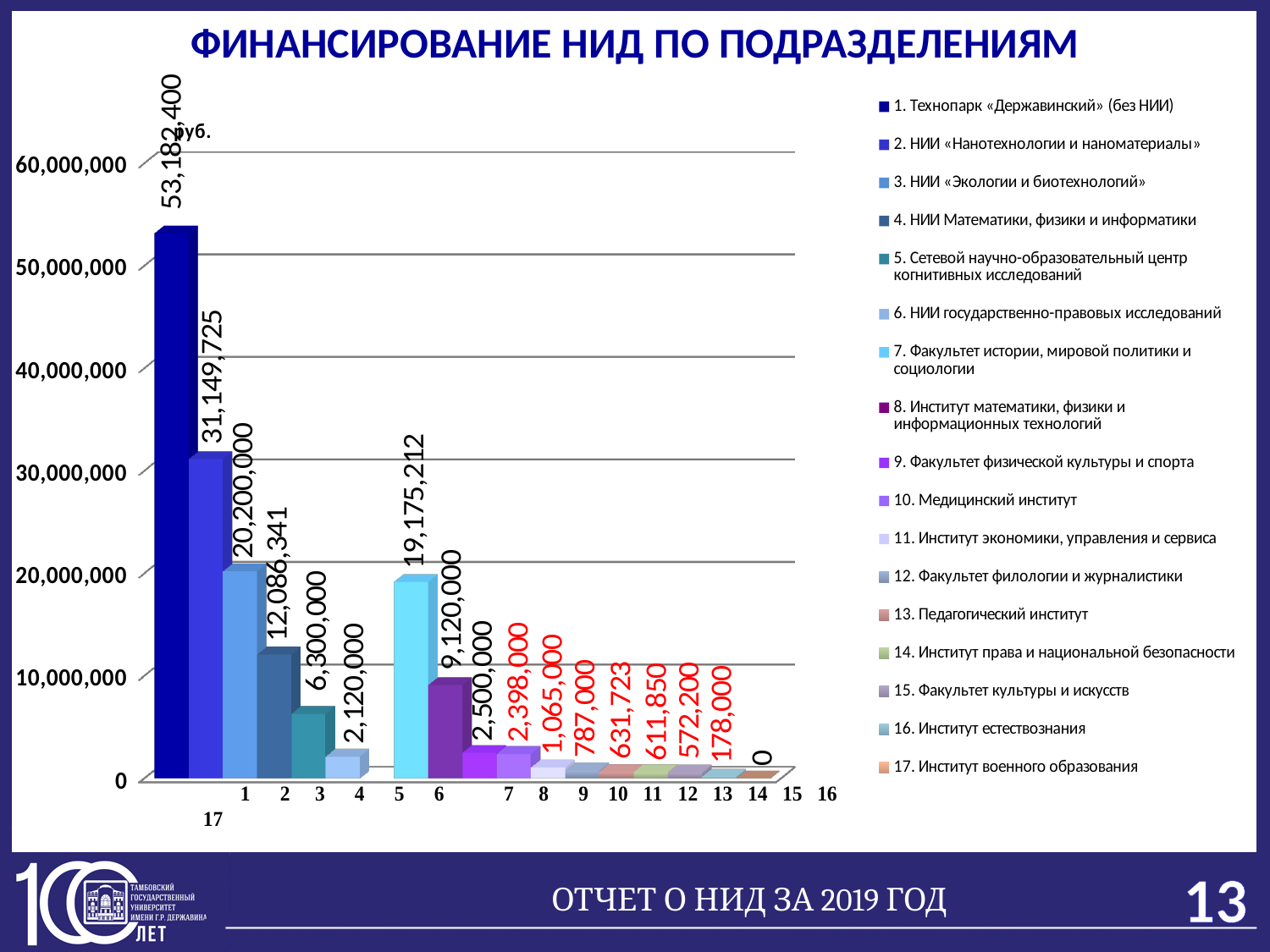
What is the difference between the values for 1. Технопарк «Державинский» (без НИИ) and 2. НИИ «Нанотехнологии и наноматериалы»? 22,032,675 What is the title of the chart? ФИНАНСИРОВАНИЕ НИД ПО ПОДРАЗДЕЛЕНИЯМ What is the value shown for 17. Институт военного образования? 0 What kind of chart is shown on the slide? bar chart Is the value for 4. НИИ Математики, физики и информатики greater or less than 10,000,000? greater Which legend entry has the highest value on the chart? 1. Технопарк «Державинский» (без НИИ) Which is larger: the value for 3. НИИ «Экологии и биотехнологий» or the value for 7. Факультет истории, мировой политики и социологии? 3. НИИ «Экологии и биотехнологий» What unit is indicated at the top of the vertical axis? руб. What is the value shown for 2. НИИ «Нанотехнологии и наноматериалы»? 31,149,725 What is the highest value shown on the chart? 53,182,400 How many entries does the chart legend list? 17 What is the value shown for 7. Факультет истории, мировой политики и социологии? 19,175,212